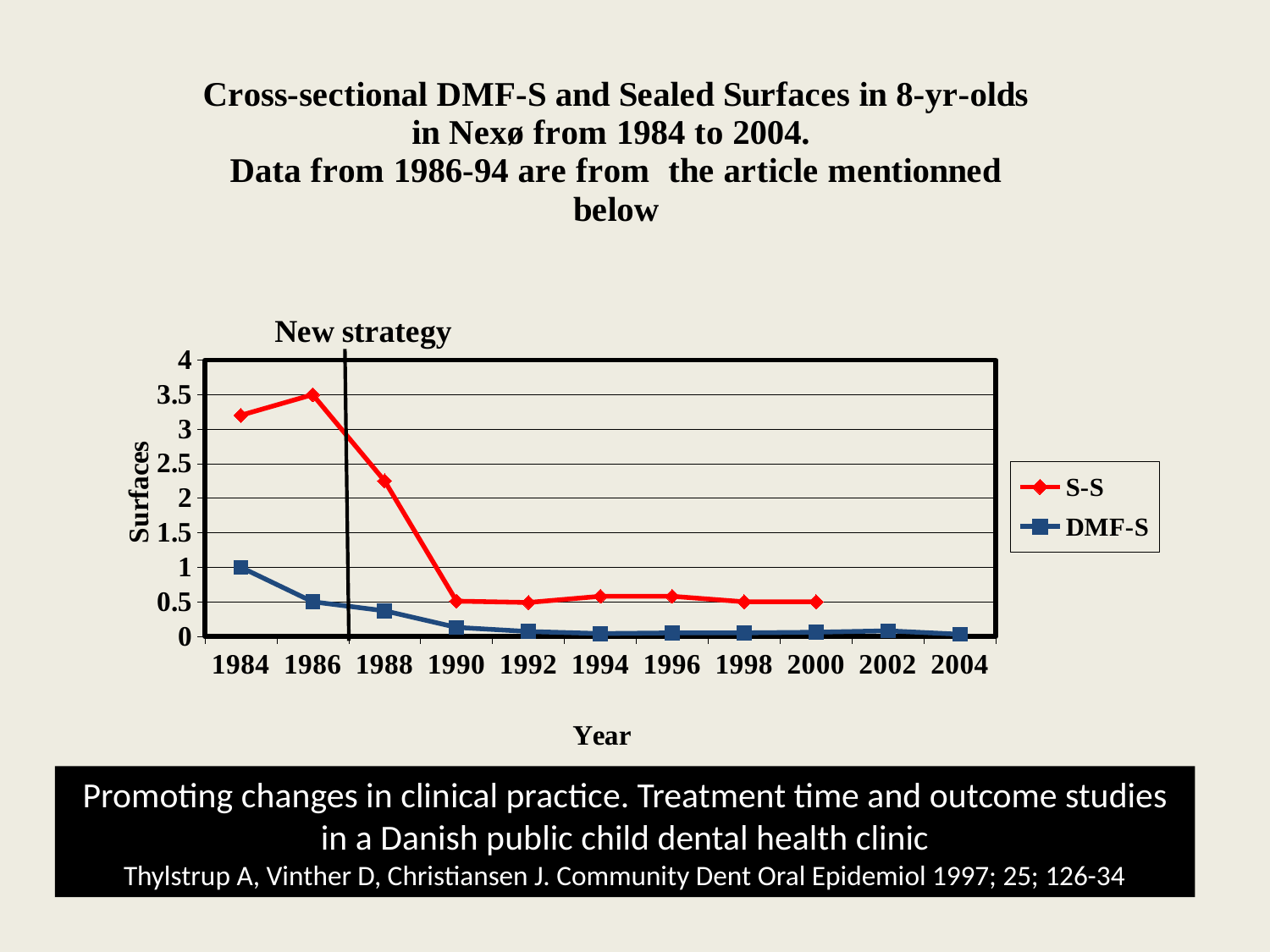
What is the value of S-S in 1986? 3.5 In which year does the S-S series reach its highest value? 1986 What kind of chart is shown on the slide? line chart How many years are labelled along the x axis? 11 Is the value for S-S in 1990 greater or less than 1? less Which series has the larger value in 1988, S-S or DMF-S? S-S How many series does the legend list? 2 What label is written above the vertical line drawn through the chart? New strategy In which year does the DMF-S series have its highest value? 1984 What are the two series named in the legend? S-S and DMF-S What is the value of DMF-S in 1984? 1 Is the value for S-S in 1984 greater or less than 3? greater